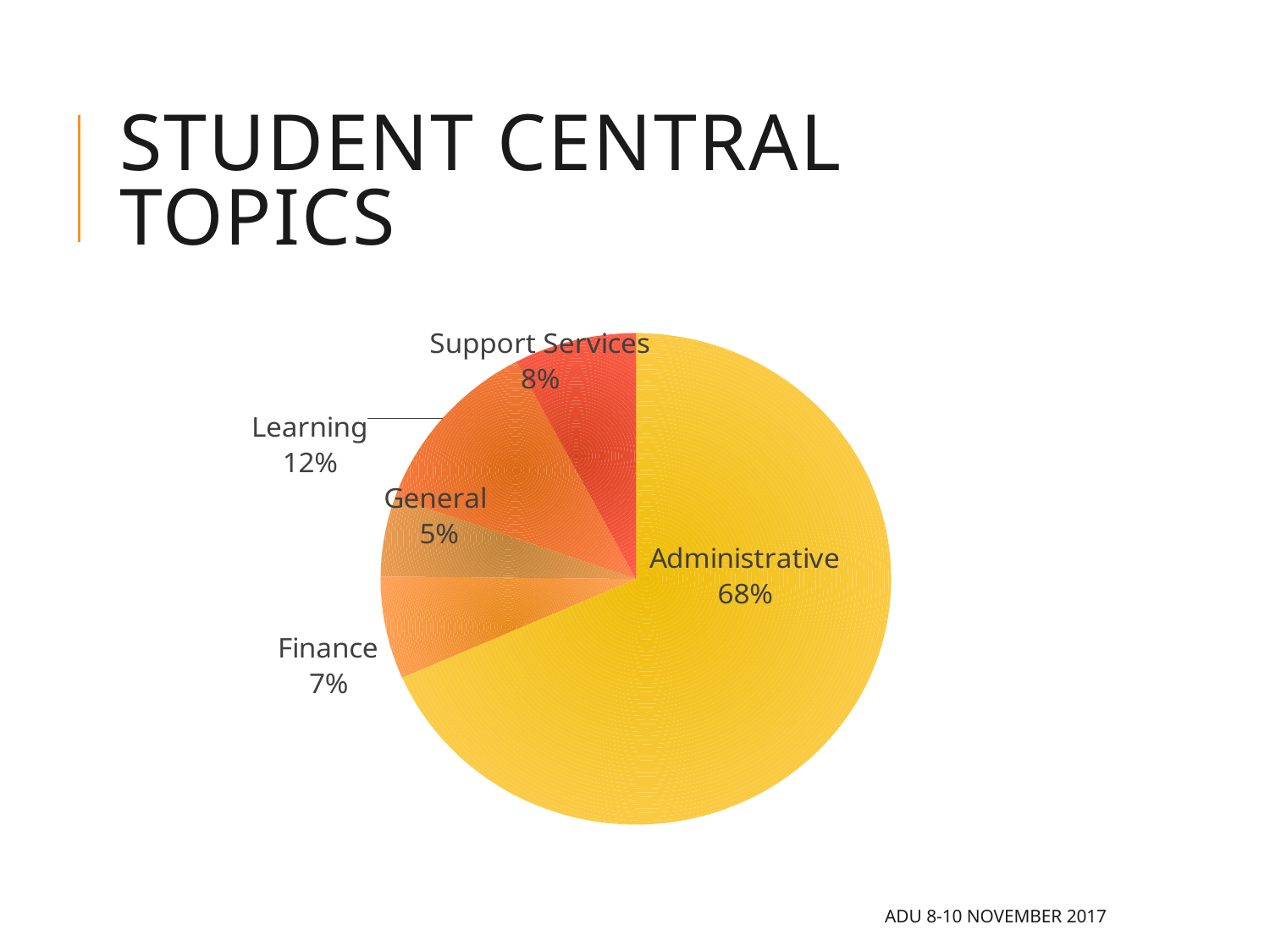
What is the title of the slide containing the pie chart? STUDENT CENTRAL TOPICS Which is larger, the Learning slice or the Support Services slice? Learning How many slices does the pie chart have? 5 What percentage is shown for Learning? 12% What is the difference in percentage points between Administrative and Learning? 56 What percentage is shown for Finance? 7% Which topic has the smallest slice of the pie? General What percentage is shown for General? 5% What percentage is shown for Support Services? 8% Which topic has the largest slice of the pie? Administrative What share of the pie does Administrative take? 68% What kind of chart is shown on the slide? pie chart